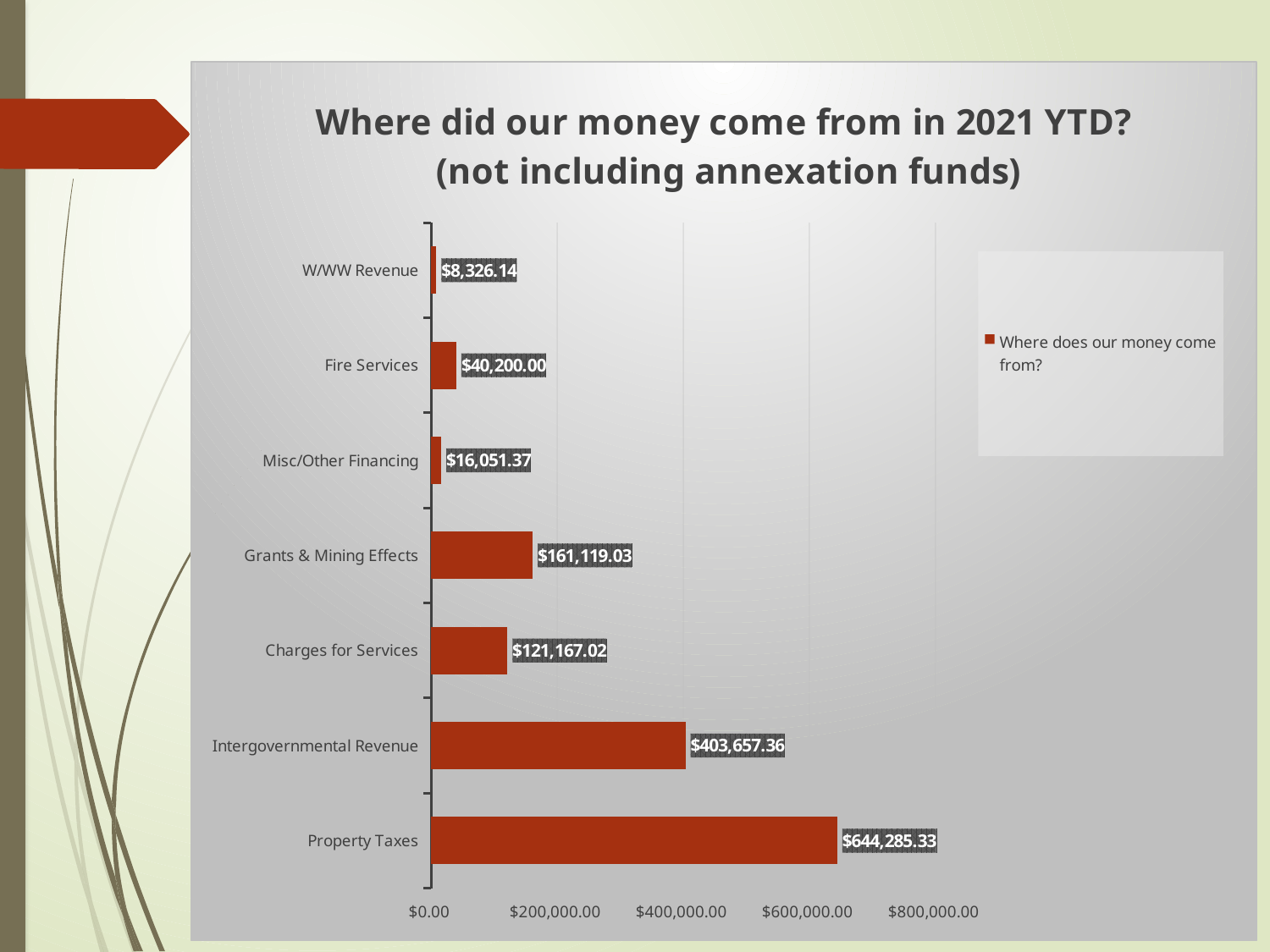
What is the value for Property Taxes? $644,285.33 Which category has the lowest value? W/WW Revenue Is the value for Intergovernmental Revenue greater or less than $400,000.00? greater What is the value for Fire Services? $40,200.00 How many categories are shown in the chart? 7 Which category has the highest value? Property Taxes What is the value for W/WW Revenue? $8,326.14 What is the value for Intergovernmental Revenue? $403,657.36 Which is larger, Fire Services or Misc/Other Financing? Fire Services What kind of chart is shown on the slide? Bar chart What is the difference between Grants & Mining Effects and Charges for Services? $39,952.01 What is the difference between Property Taxes and Intergovernmental Revenue? $240,627.97